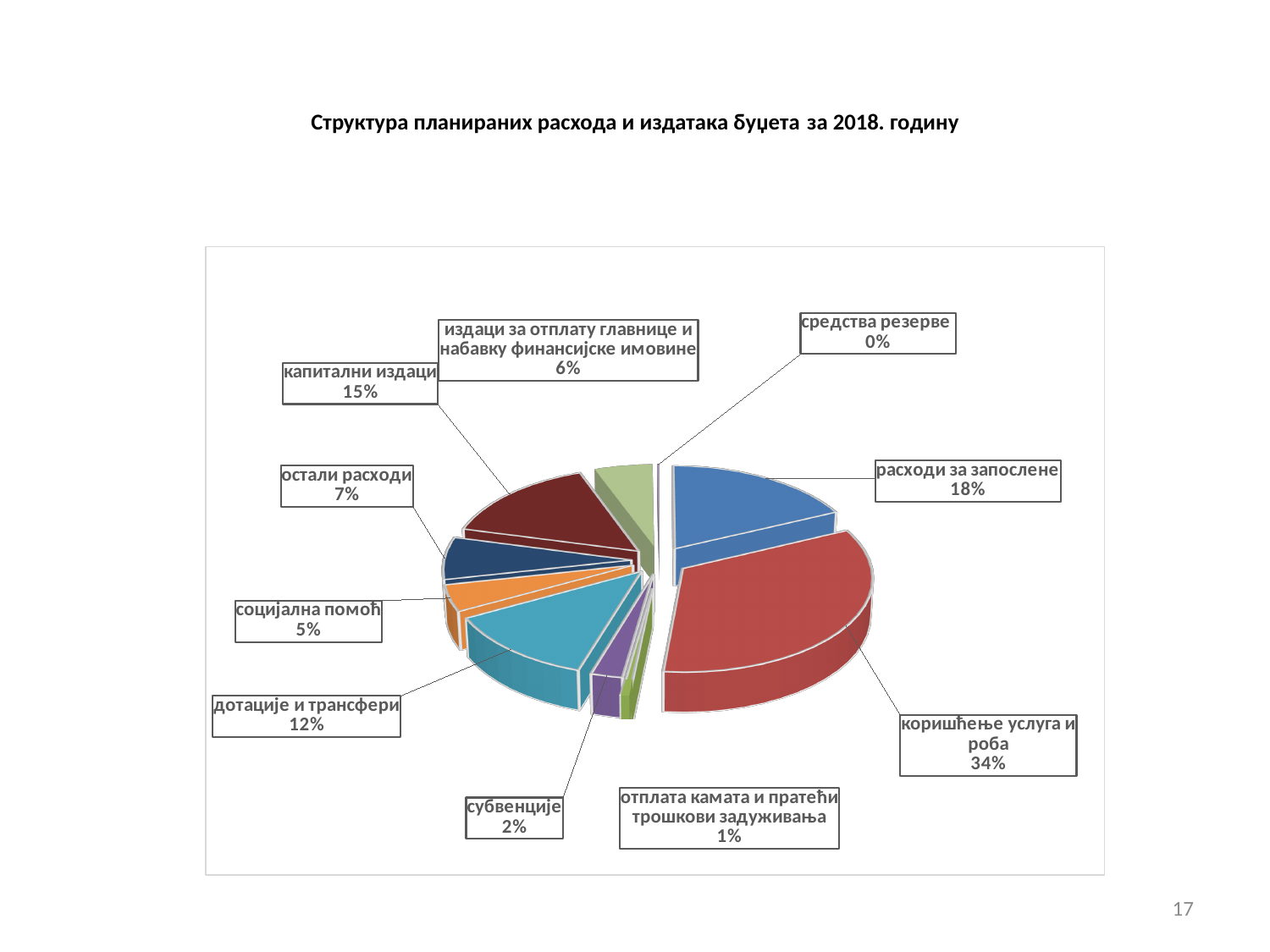
What is the value shown for "капитални издаци"? 15% Which category has the largest share of the pie? коришћење услуга и роба What is the value shown for "отплата камата и пратећи трошкови задуживања"? 1% What share of the pie does "коришћење услуга и роба" have? 34% What is the title of the slide? Структура планираних расхода и издатака буџета за 2018. годину Which category has the smallest share of the pie? средства резерве What is the value shown for "расходи за запослене"? 18% What is the value shown for "дотације и трансфери"? 12% Which is larger, the share for "остали расходи" or the share for "социјална помоћ"? остали расходи What is the difference between the shares of "коришћење услуга и роба" and "расходи за запослене"? 16% How many categories are shown in the pie chart? 10 What kind of chart is shown on the slide? Pie chart